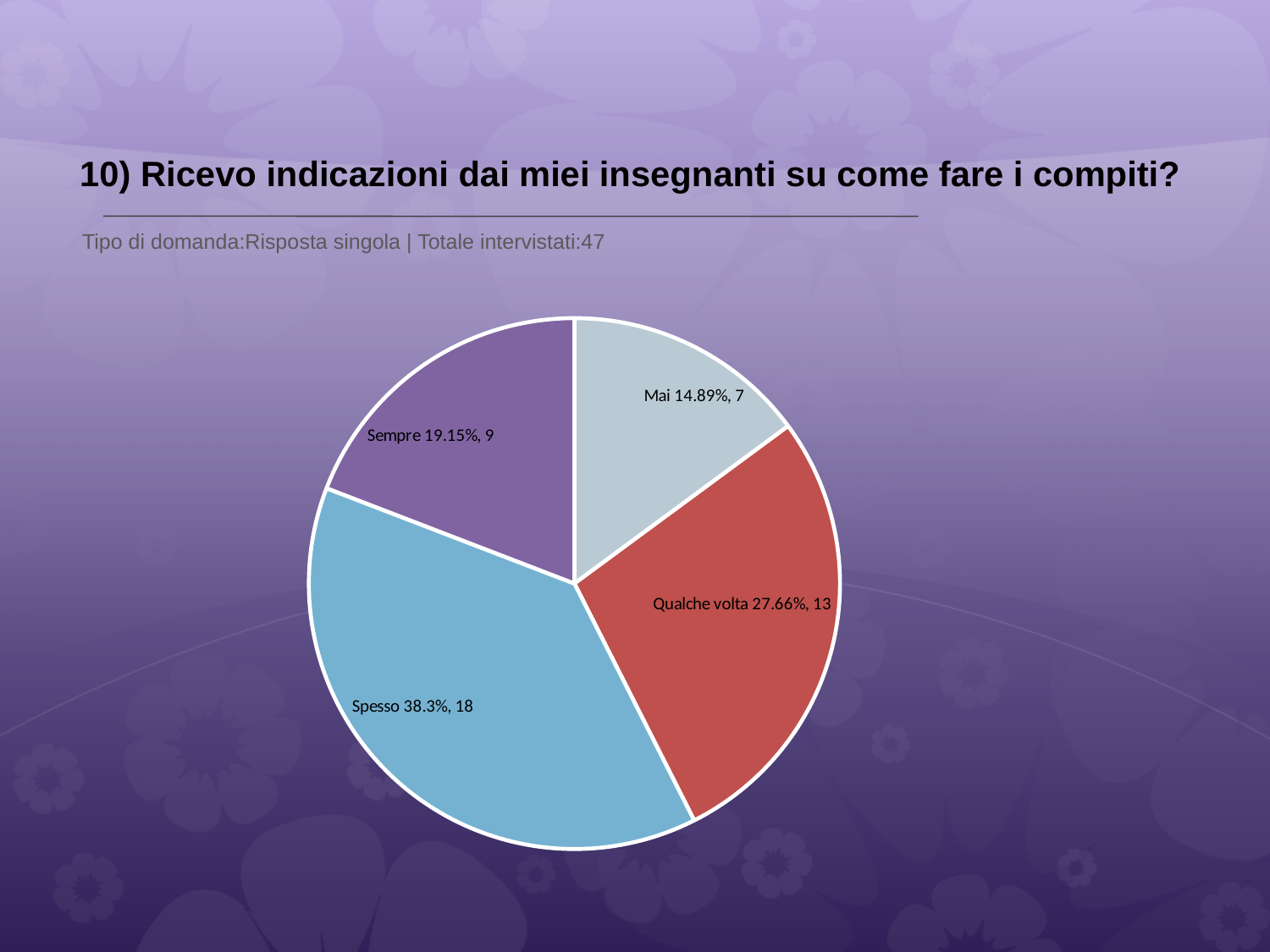
Which category has the smallest slice? Mai What kind of chart is shown on the slide? pie chart What percentage share does the 'Mai' slice have? 14.89% Which category has the largest slice? Spesso What is the difference in respondent count between 'Spesso' and 'Mai'? 11 Which has more respondents, 'Qualche volta' or 'Sempre'? Qualche volta What colour is the 'Qualche volta' slice? red How many respondents answered 'Qualche volta'? 13 What is the total number of respondents across all slices? 47 What percentage share does the 'Spesso' slice have? 38.3% How many slices does the pie chart have? 4 How many respondents answered 'Sempre'? 9